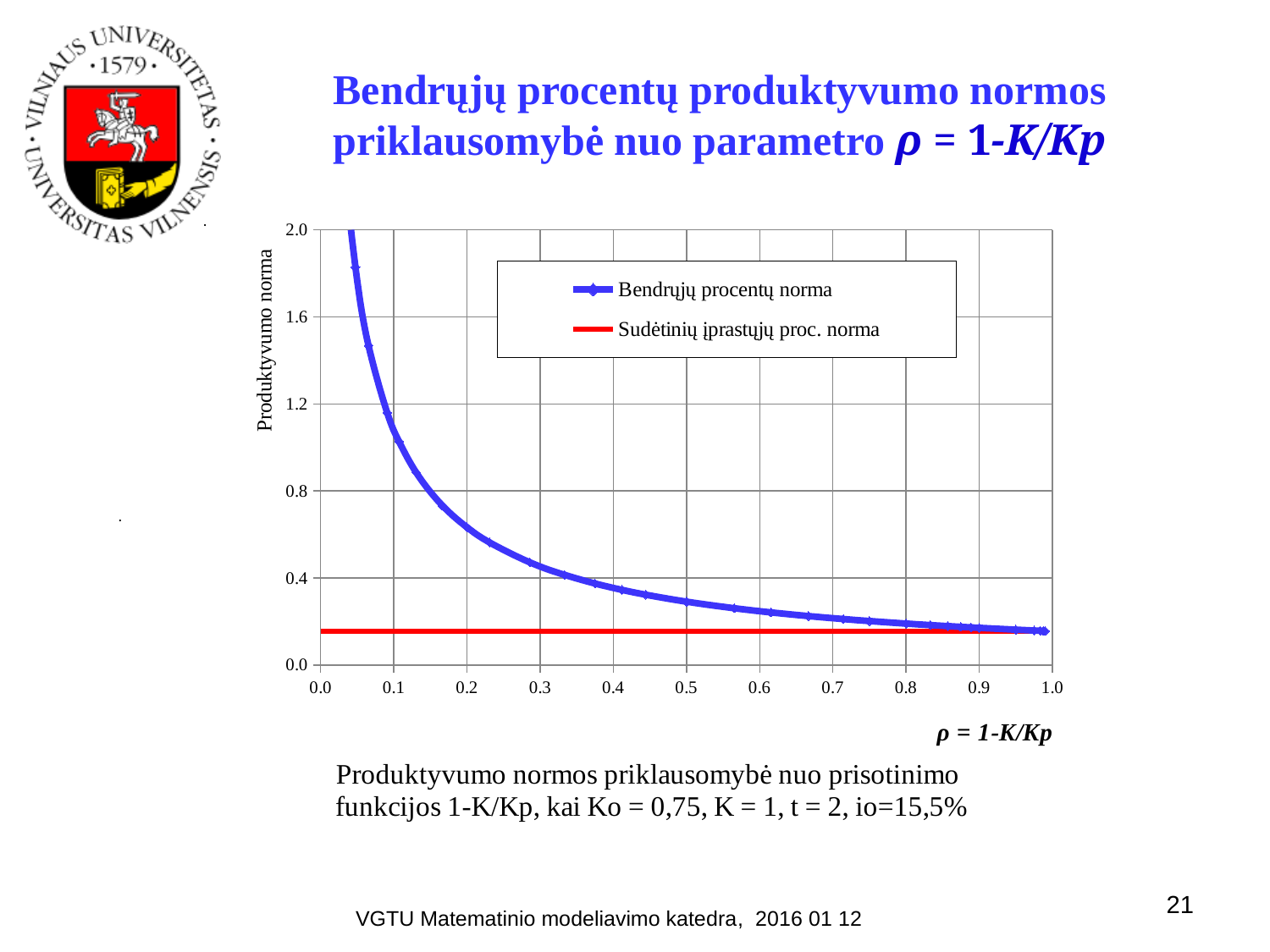
What kind of chart is shown on the slide? line chart Is the value of 'Bendrųjų procentų norma' at ρ = 0.5 greater or less than 0.4? less What is the label of the vertical axis? Produktyvumo norma At ρ = 0.3, which series has the larger value, 'Bendrųjų procentų norma' or 'Sudėtinių įprastųjų proc. norma'? Bendrųjų procentų norma What is the highest tick value shown on the horizontal axis? 1.0 How many series does the legend list? 2 What is the highest tick value shown on the vertical axis? 2.0 Which series is drawn as a horizontal red line? Sudėtinių įprastųjų proc. norma Is the value of 'Bendrųjų procentų norma' at ρ = 0.1 greater or less than 0.8? greater Is the value of 'Sudėtinių įprastųjų proc. norma' greater or less than 0.4? less Does the value of the 'Bendrųjų procentų norma' series rise or fall as ρ increases along the x axis? fall